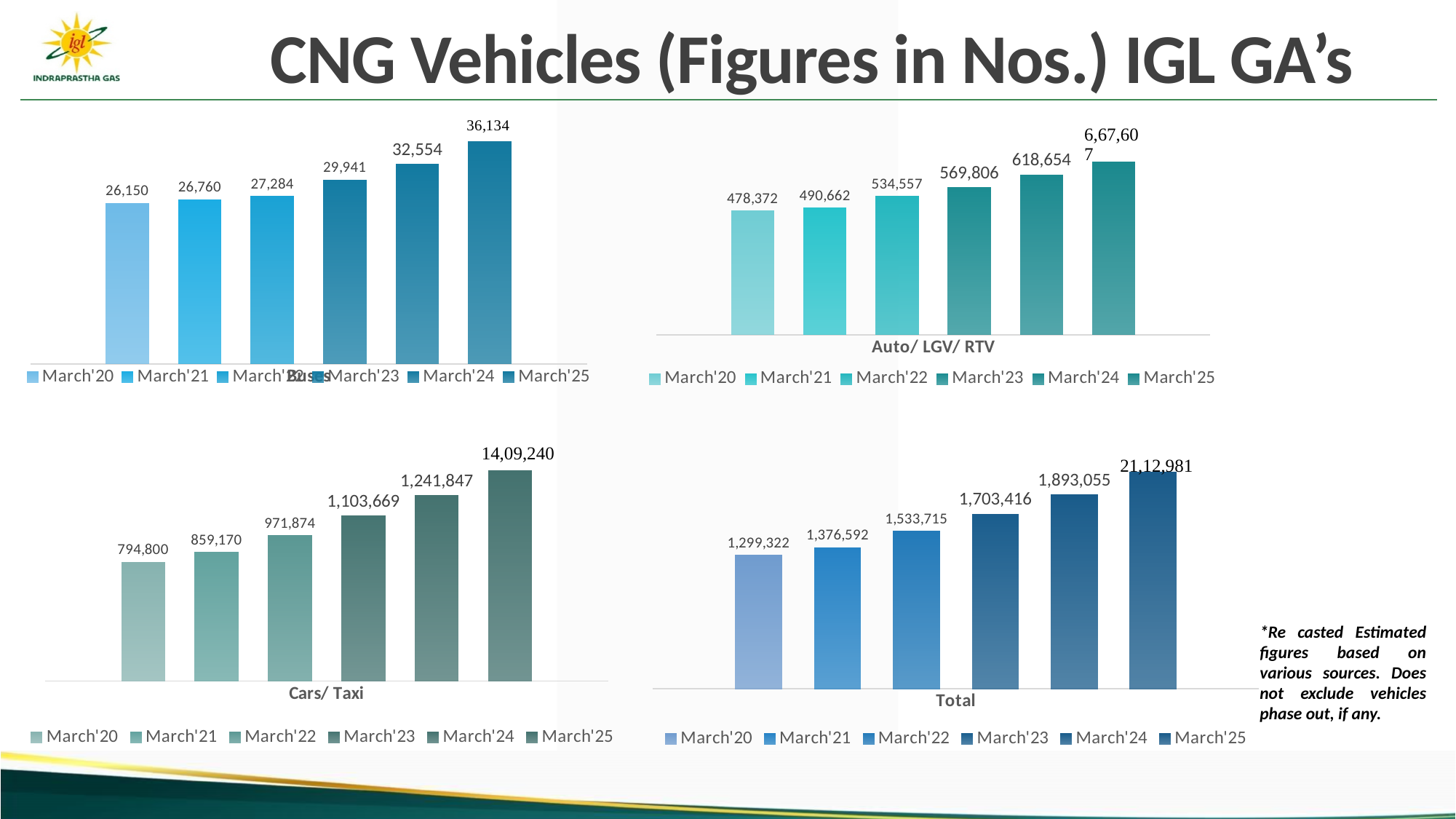
In the Cars/ Taxi chart, what is the value for March'24? 1,241,847 In the top-left (Buses) chart, what is the value for March'25? 36,134 In the Cars/ Taxi chart, which year has the lowest value? March'20 In the Total chart, what is the value for March'20? 1,299,322 In the top-left (Buses) chart, what is the difference between the March'24 and March'23 values? 2,613 In the Total chart, which year has the highest value? March'25 In the Auto/ LGV/ RTV chart, what is the value for March'22? 534,557 Do the values in the Auto/ LGV/ RTV chart rise or fall from March'20 to March'25? rise How many bars are plotted in the Cars/ Taxi chart? 6 In the top-left (Buses) chart, what is the value for March'23? 29,941 How many entries does the legend of the Total chart list? 6 In the Auto/ LGV/ RTV chart, which is larger, the value for March'23 or March'24? March'24